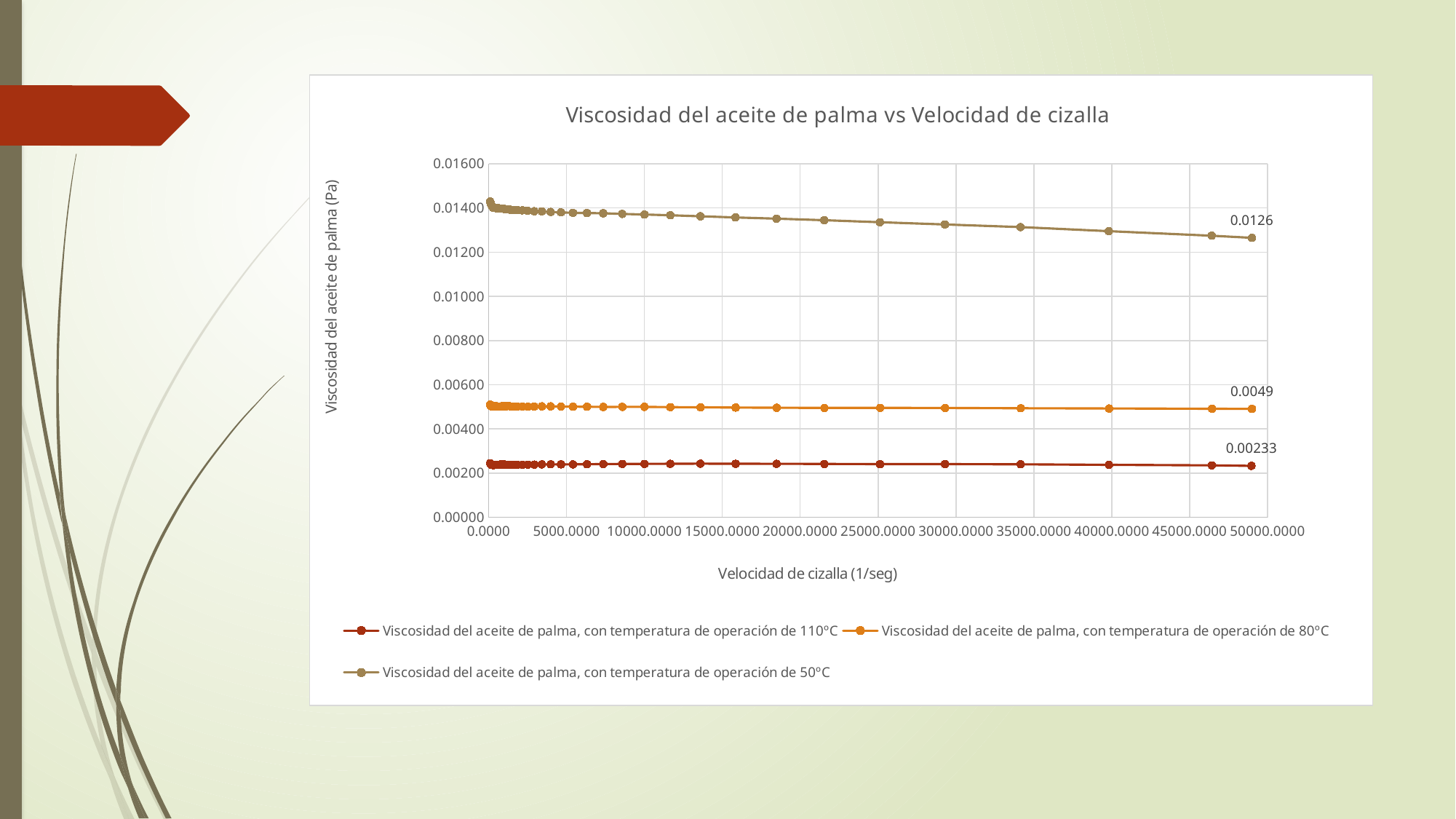
What is the label of the x axis? Velocidad de cizalla (1/seg) How many series does the legend list? 3 Which series has the lowest viscosity values? Viscosidad del aceite de palma, con temperatura de operación de 110°C What is the final labelled value for the series with operating temperature of 80°C? 0.0049 What kind of chart is shown on the slide? line chart What is the final labelled value for the series with operating temperature of 50°C? 0.0126 What is the title of the chart? Viscosidad del aceite de palma vs Velocidad de cizalla What is the final labelled value for the series with operating temperature of 110°C? 0.00233 Which series has the highest viscosity values? Viscosidad del aceite de palma, con temperatura de operación de 50°C Does the viscosity for the 50°C series rise or fall as the shear rate increases? fall Which is larger, the final labelled value for the 80°C series or the final labelled value for the 110°C series? 80°C series Is the viscosity for the 50°C series at a shear rate of 0 greater or less than 0.01200? greater